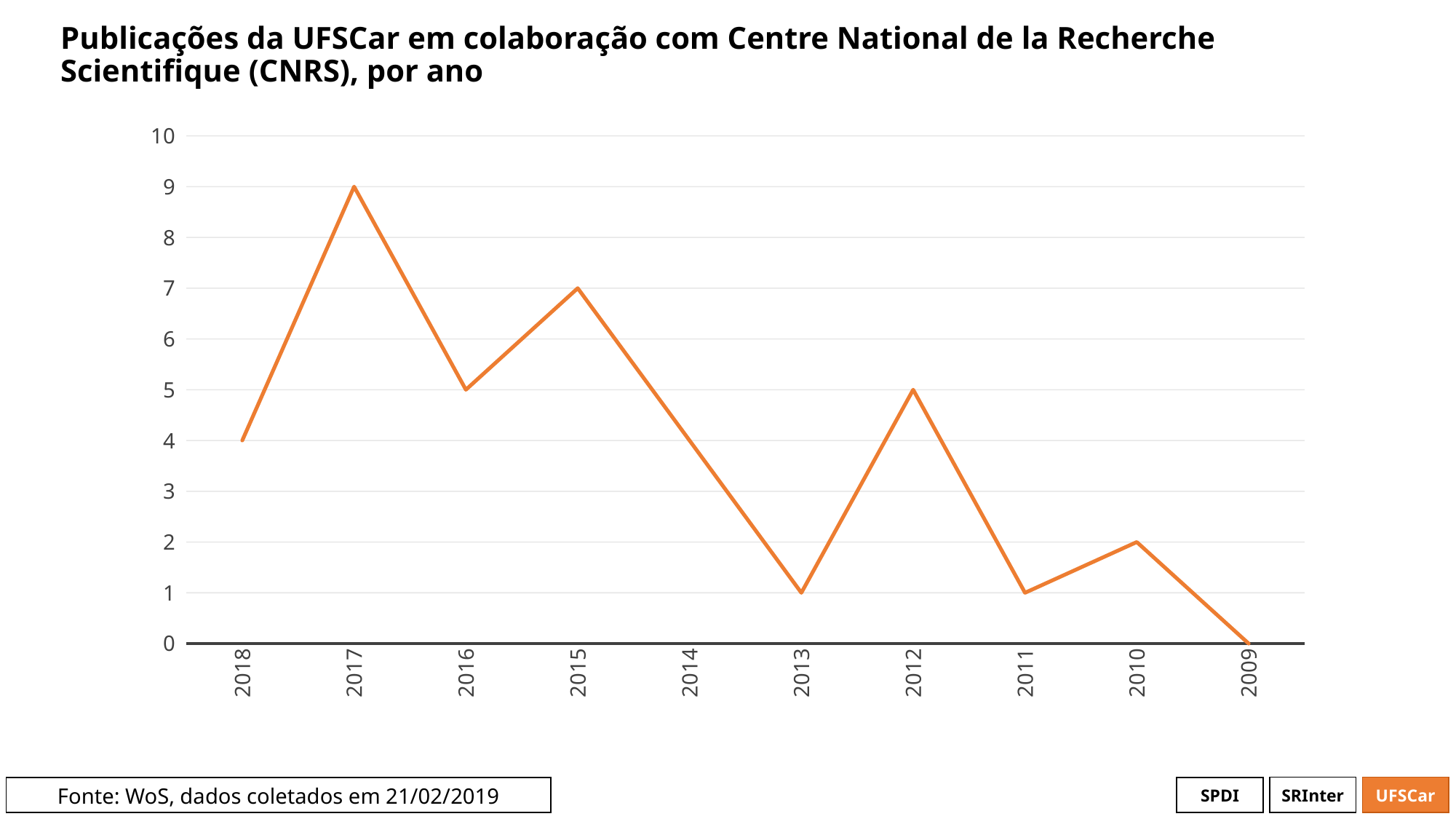
What type of chart is shown on the slide? line chart What is the number of publications for 2017? 9 Which year has a larger value, 2012 or 2010? 2012 What is the difference between the values for 2017 and 2016? 4 Is the value for 2013 greater or less than 3? less Which year has the highest number of publications? 2017 How many years are plotted on the x axis? 10 Which year has the lowest number of publications? 2009 What is the number of publications for 2015? 7 What is the number of publications for 2018? 4 What is the number of publications for 2009? 0 What is the title of the chart? Publicações da UFSCar em colaboração com Centre National de la Recherche Scientifique (CNRS), por ano